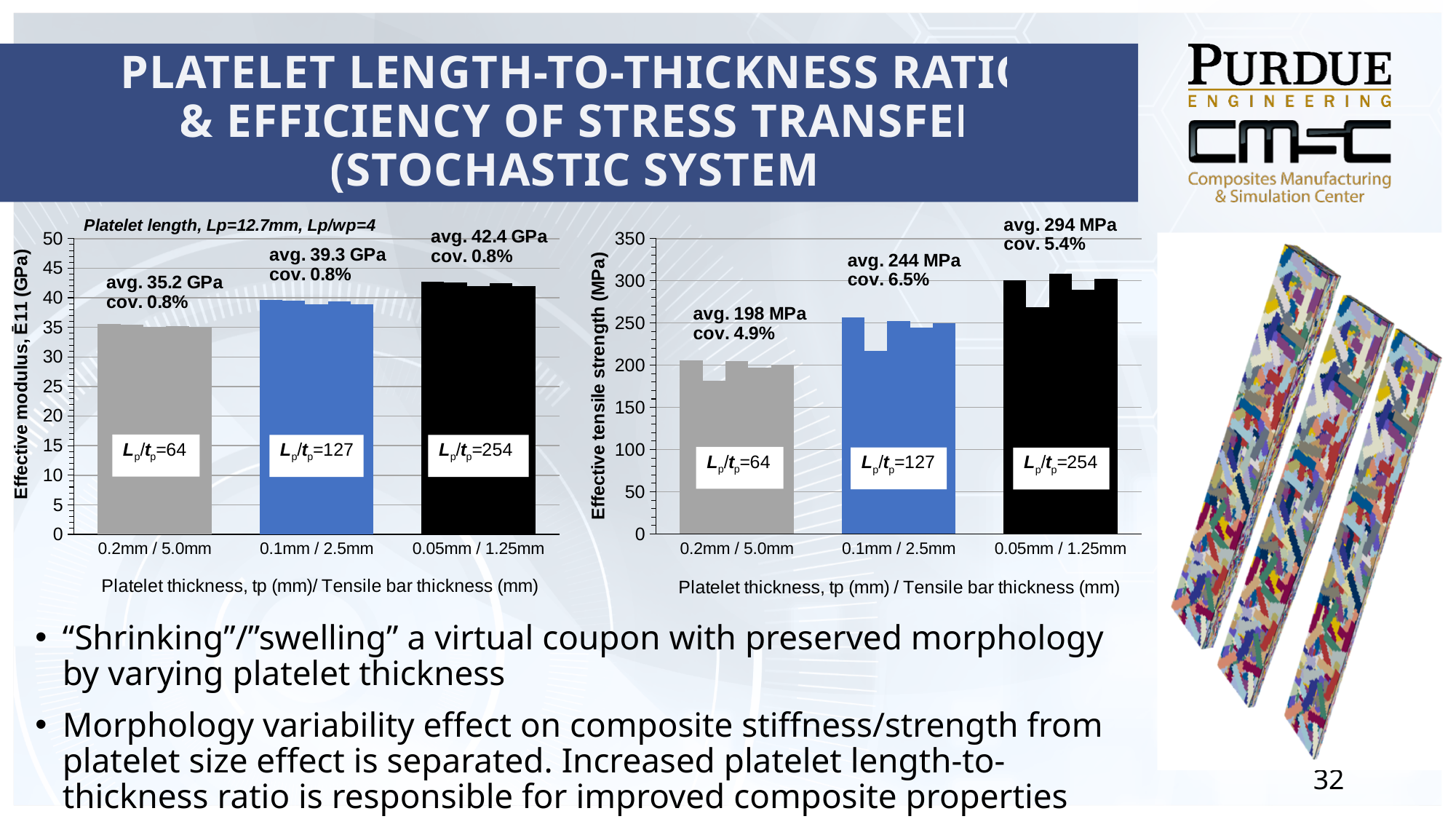
In the left chart (Effective modulus), what is the average value labelled for the 0.2mm / 5.0mm category? 35.2 GPa In the left chart (Effective modulus), do the average values rise or fall from left to right along the x axis? rise In the right chart (Effective tensile strength), which category has the highest average tensile strength? 0.05mm / 1.25mm In the right chart (Effective tensile strength), what is the difference between the average values for 0.05mm / 1.25mm and 0.2mm / 5.0mm? 96 MPa In the right chart (Effective tensile strength), what coefficient of variation is labelled for the 0.1mm / 2.5mm category? 6.5% In the right chart (Effective tensile strength), what is the average value labelled for the 0.1mm / 2.5mm category? 244 MPa In the right chart (Effective tensile strength), is the average for 0.1mm / 2.5mm larger or smaller than the average for 0.2mm / 5.0mm? larger How many categories are shown on the x axis of the left chart (Effective modulus)? 3 In the left chart (Effective modulus), which category has the lowest average modulus? 0.2mm / 5.0mm What kind of chart is the right chart (Effective tensile strength)? bar chart In the left chart (Effective modulus), what is the difference between the average values for 0.05mm / 1.25mm and 0.2mm / 5.0mm? 7.2 GPa In the left chart (Effective modulus), what is the average value labelled for the 0.05mm / 1.25mm category? 42.4 GPa